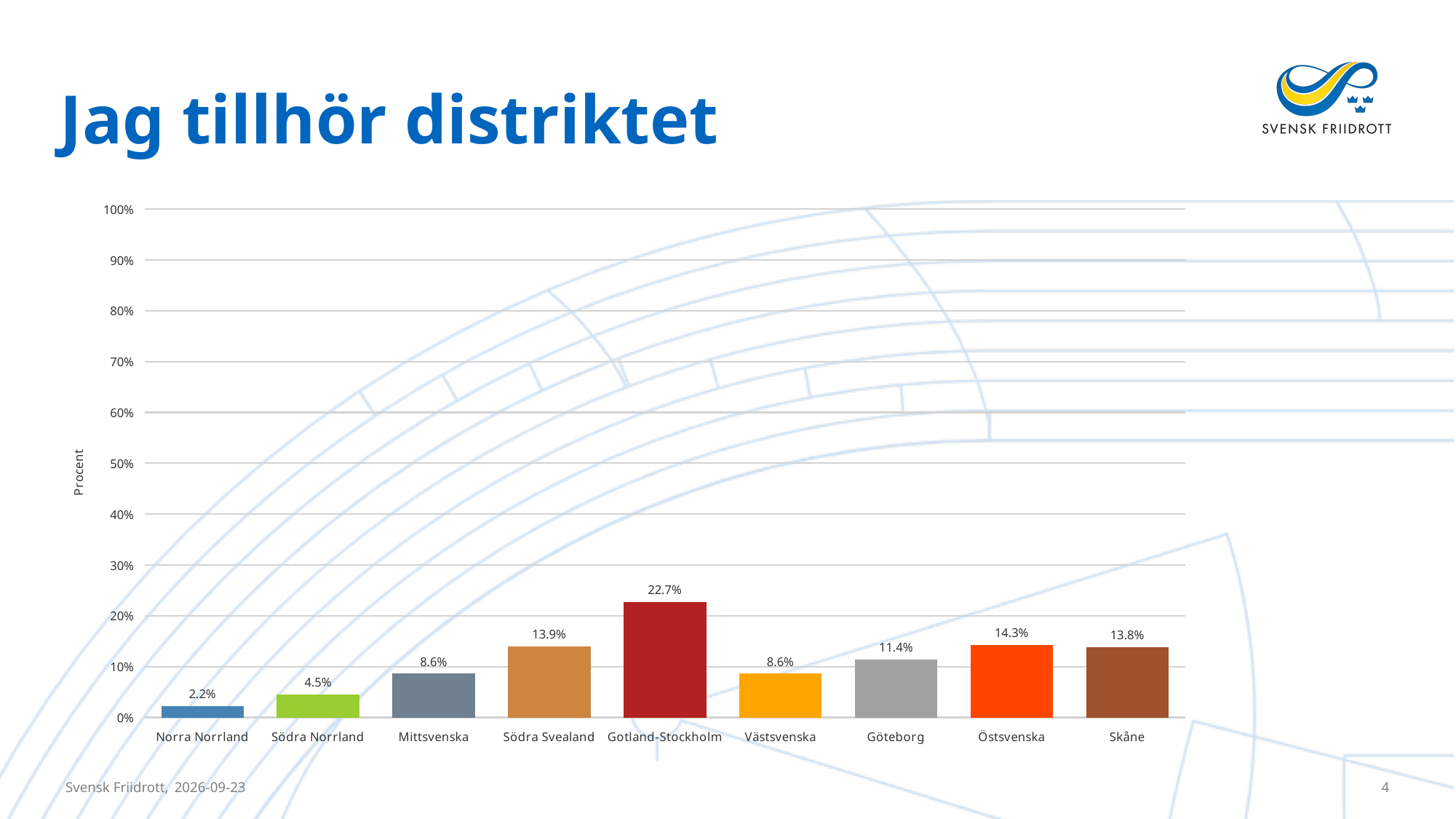
What is the value for Norra Norrland? 2.2% What is the value for Göteborg? 11.4% What is the difference between the values for Gotland-Stockholm and Skåne? 8.9% What is the label of the vertical axis? Procent What is the value for Gotland-Stockholm? 22.7% Which is larger, the value for Östsvenska or the value for Göteborg? Östsvenska Which district has the highest value? Gotland-Stockholm Which district has the lowest value? Norra Norrland Is the value for Gotland-Stockholm greater or less than 20%? greater What is the difference between the values for Södra Norrland and Norra Norrland? 2.3% How many districts are shown on the x axis? 9 What kind of chart is shown on the slide? bar chart